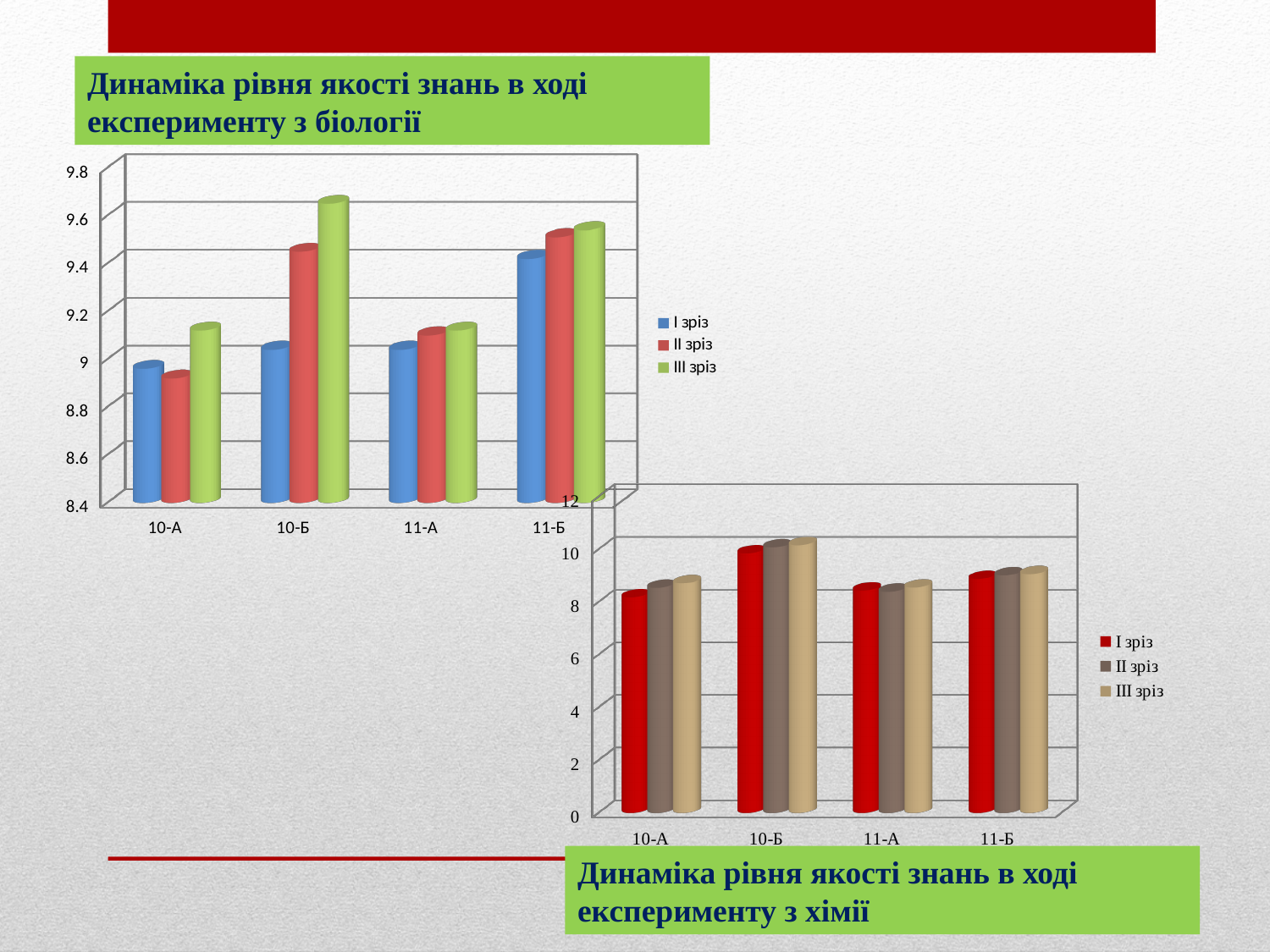
On the biology chart (top left), which is larger: III зріз for 10-Б or III зріз for 10-А? III зріз for 10-Б On the chemistry chart (bottom right), which category has the tallest bars? 10-Б On the biology chart (top left), how many series does the legend list? 3 On the biology chart (top left), which series has the tallest bar for 10-Б? III зріз On the chemistry chart (bottom right), is the value of I зріз for 10-Б greater or less than 8? greater On the biology chart (top left), is the value of III зріз for 10-Б greater or less than 9.4? greater On the biology chart (top left), which category has the tallest bar overall? 10-Б On the chemistry chart (bottom right), which category has the lowest I зріз value? 10-А What is the title of the chart in the bottom right of the slide? Динаміка рівня якості знань в ході експерименту з хімії What type of chart is the chemistry chart (bottom right)? bar chart On the biology chart (top left), is the value of II зріз for 10-А greater or less than 9? less On the biology chart (top left), how many categories are shown on the x axis? 4